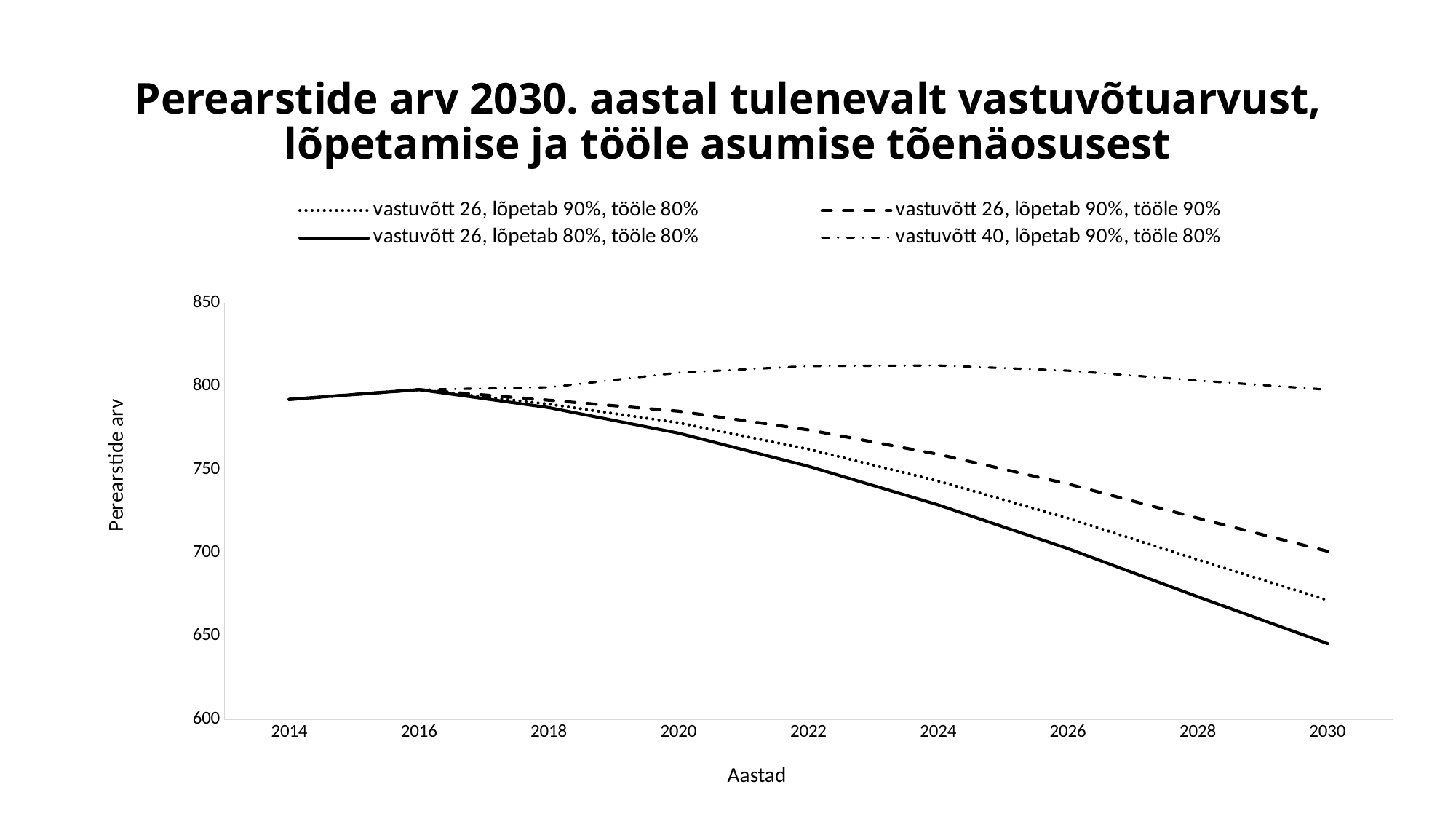
What is the title of the x axis? Aastad How many series does the legend list? 4 Which series has the lowest value in 2030? vastuvõtt 26, lõpetab 80%, tööle 80% Is the value for 'vastuvõtt 26, lõpetab 90%, tööle 80%' in 2030 greater or less than 700? less How many year labels are shown on the x axis? 9 Is the value for 'vastuvõtt 40, lõpetab 90%, tööle 80%' in 2024 greater or less than 800? greater Does the 'vastuvõtt 26, lõpetab 80%, tööle 80%' line rise or fall from 2016 to 2030? fall Which series has the highest value in 2030? vastuvõtt 40, lõpetab 90%, tööle 80% In 2030, which is higher: 'vastuvõtt 26, lõpetab 90%, tööle 90%' or 'vastuvõtt 26, lõpetab 90%, tööle 80%'? vastuvõtt 26, lõpetab 90%, tööle 90% What kind of chart is shown on the slide? line chart Is the value for 'vastuvõtt 26, lõpetab 80%, tööle 80%' in 2024 greater or less than 750? less What is the title of the y axis? Perearstide arv